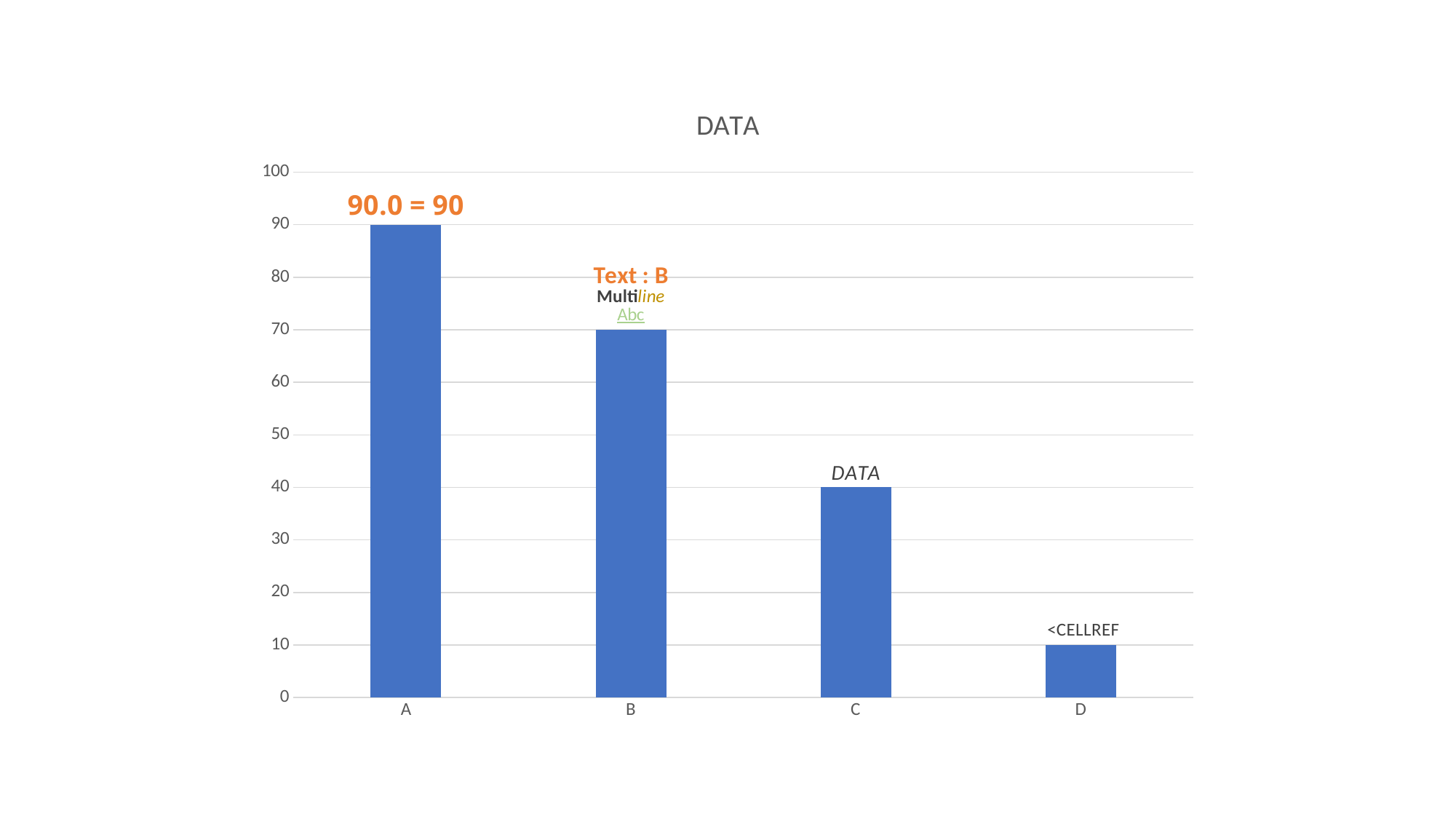
Is the value for C greater or less than 50? less What is the value for category A? 90 What kind of chart is shown? bar chart What is the value for category C? 40 What is the value for category B? 70 What is the title of the chart? DATA Which category has the lowest value? D What is the value for category D? 10 How many categories are shown on the x axis? 4 Which category has the highest value? A What is the difference between the values for A and B? 20 Which is larger, the value for C or the value for D? C